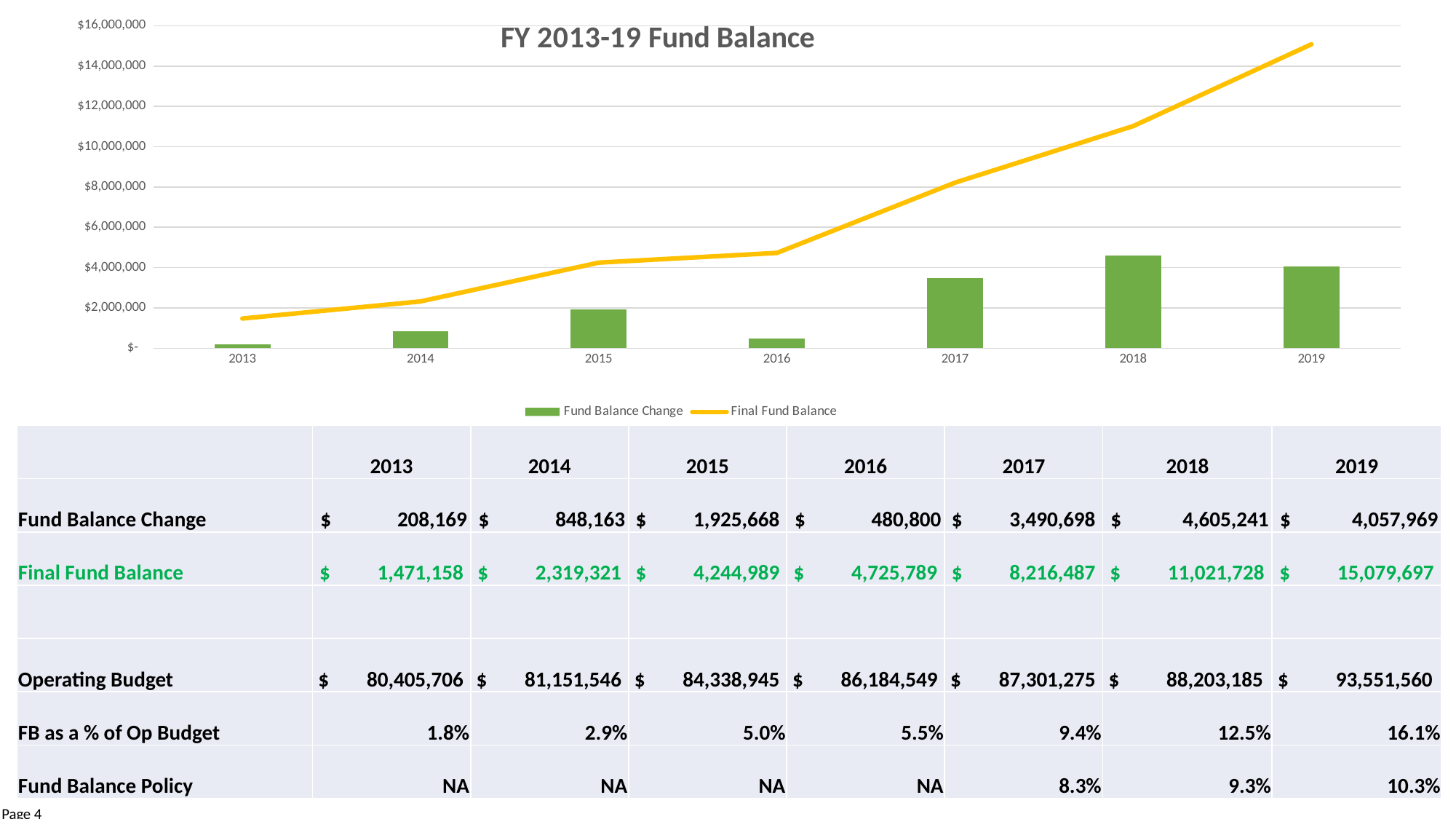
Is the Final Fund Balance for 2016 greater or less than $6,000,000? less Which is larger, the Fund Balance Change for 2015 or for 2016? 2015 What is the Final Fund Balance for 2019? $15,079,697 Which year has the highest Fund Balance Change? 2018 What is the title of the chart? FY 2013-19 Fund Balance Does the Final Fund Balance line rise or fall from 2013 to 2019? rise Is the Fund Balance Change for 2017 greater or less than $2,000,000? greater How many years are plotted along the x axis of the chart? 7 What is the Fund Balance Change for 2018? $4,605,241 How many series does the chart legend list? 2 Which year has the lowest Fund Balance Change? 2013 What is the difference between the Final Fund Balance in 2019 and in 2018? $4,057,969